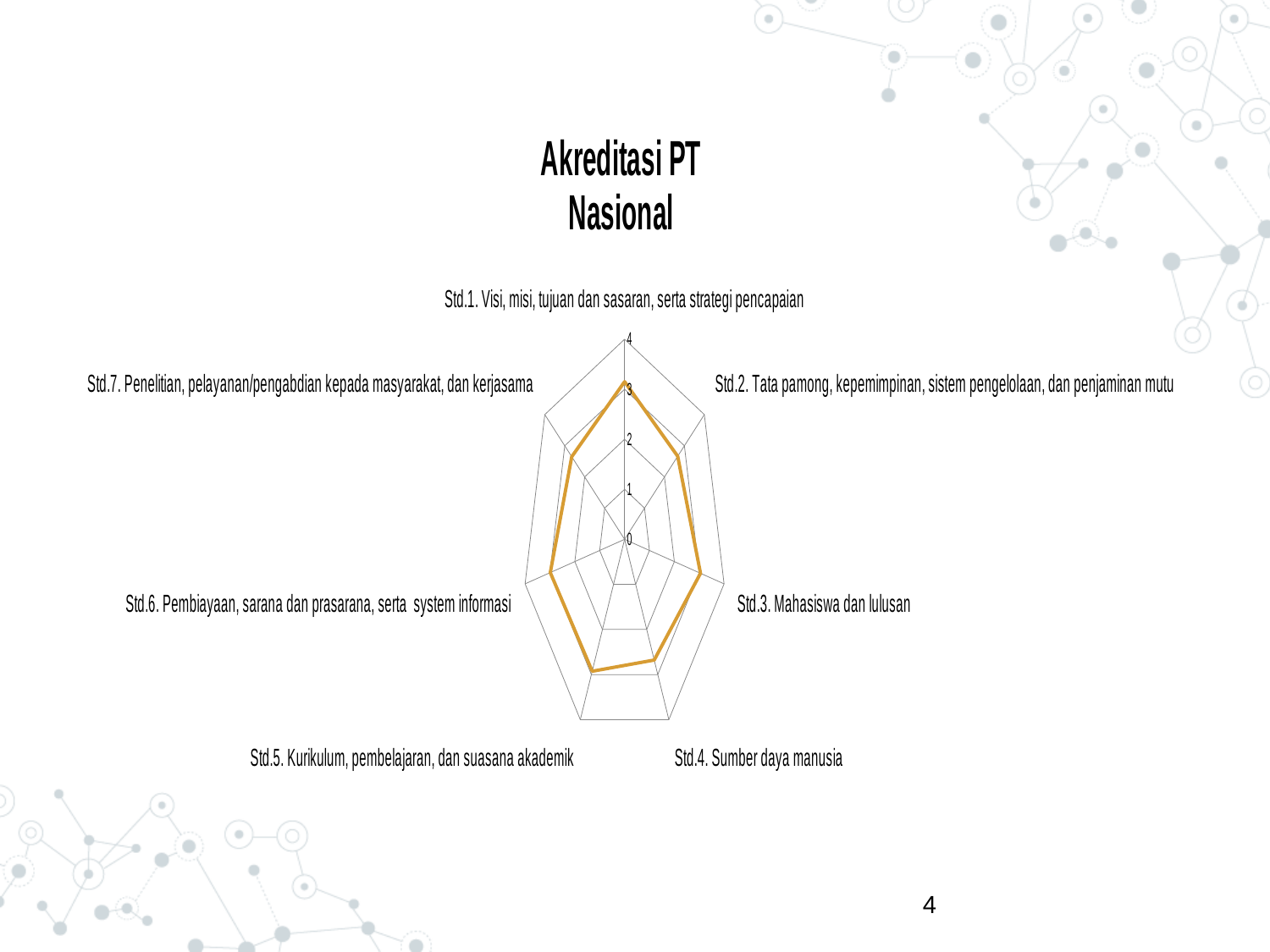
What is the title of the chart? Akreditasi PT Nasional Is the value for Std.2. Tata pamong, kepemimpinan, sistem pengelolaan, dan penjaminan mutu greater or less than 4? less Is the value for Std.1. Visi, misi, tujuan dan sasaran, serta strategi pencapaian greater or less than 2? greater Is the value for Std.3. Mahasiswa dan lulusan greater or less than 4? less What kind of chart is shown on the slide? radar chart How many categories (standards) does the radar chart have? 7 What is the highest value shown on the chart's axis scale? 4